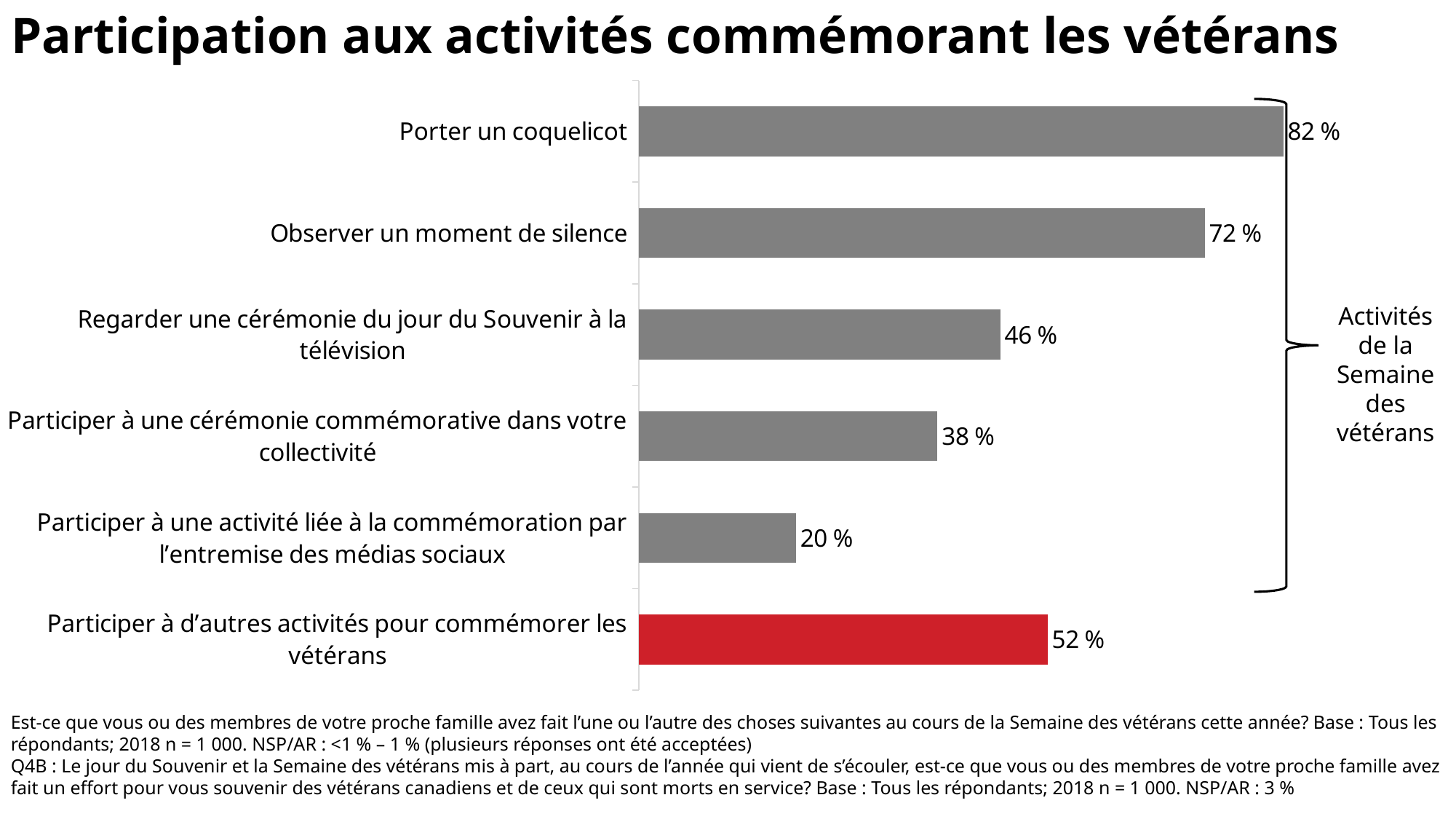
What percentage of respondents reported wearing a poppy (Porter un coquelicot)? 82 % What is the value shown for 'Observer un moment de silence'? 72 % What is the difference in percentage points between watching a Remembrance Day ceremony on television and attending a commemorative ceremony in the community? 8 Which activity has the highest participation percentage? Porter un coquelicot Which is larger: the value for 'Participer à d'autres activités pour commémorer les vétérans' or the value for 'Regarder une cérémonie du jour du Souvenir à la télévision'? Participer à d'autres activités pour commémorer les vétérans Which activity has the lowest participation percentage? Participer à une activité liée à la commémoration par l'entremise des médias sociaux Which bar is coloured red rather than grey? Participer à d'autres activités pour commémorer les vétérans What is the difference in percentage points between 'Porter un coquelicot' and 'Observer un moment de silence'? 10 What type of chart is shown on the slide? Bar chart What percentage is shown for participating in a commemoration activity via social media (médias sociaux)? 20 % What is the value for 'Participer à d'autres activités pour commémorer les vétérans'? 52 % How many activity categories are shown in the chart? 6